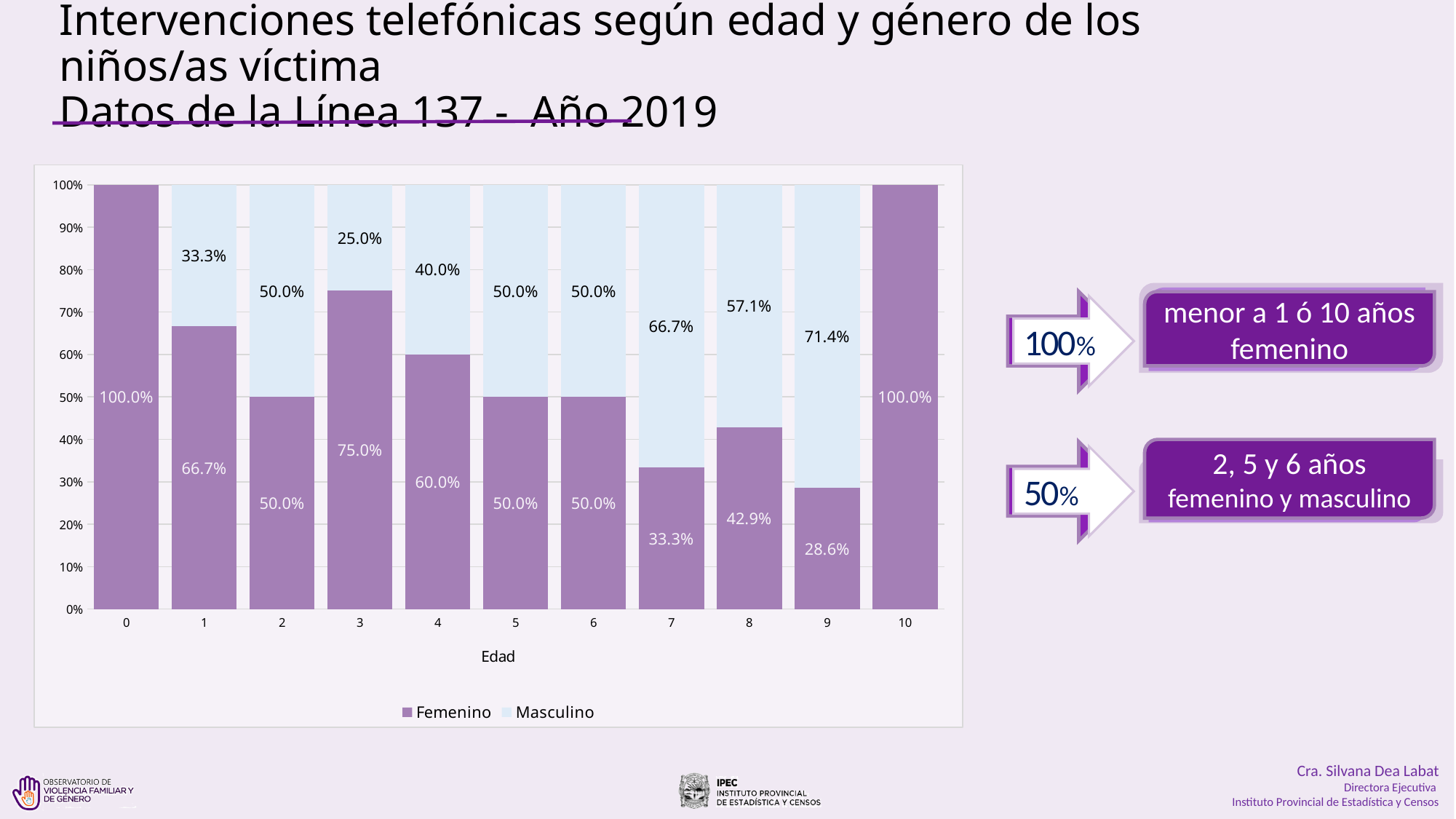
What is the Femenino value for age 8? 42.9% What is the Femenino value for age 3? 75.0% How many series does the legend list? 2 What kind of chart is shown on the slide? Stacked bar chart How many age categories are shown on the x axis? 11 What is the difference between the Masculino value for age 8 and the Masculino value for age 3? 32.1% What is the Masculino value for age 9? 71.4% What is the label of the x axis? Edad Among ages 1 to 9, which age has the highest Masculino share? 9 Among ages 1 to 9, which age has the lowest Femenino share? 9 What is the Masculino value for age 1? 33.3% Which is larger, the Femenino value for age 4 or the Femenino value for age 7? Femenino value for age 4